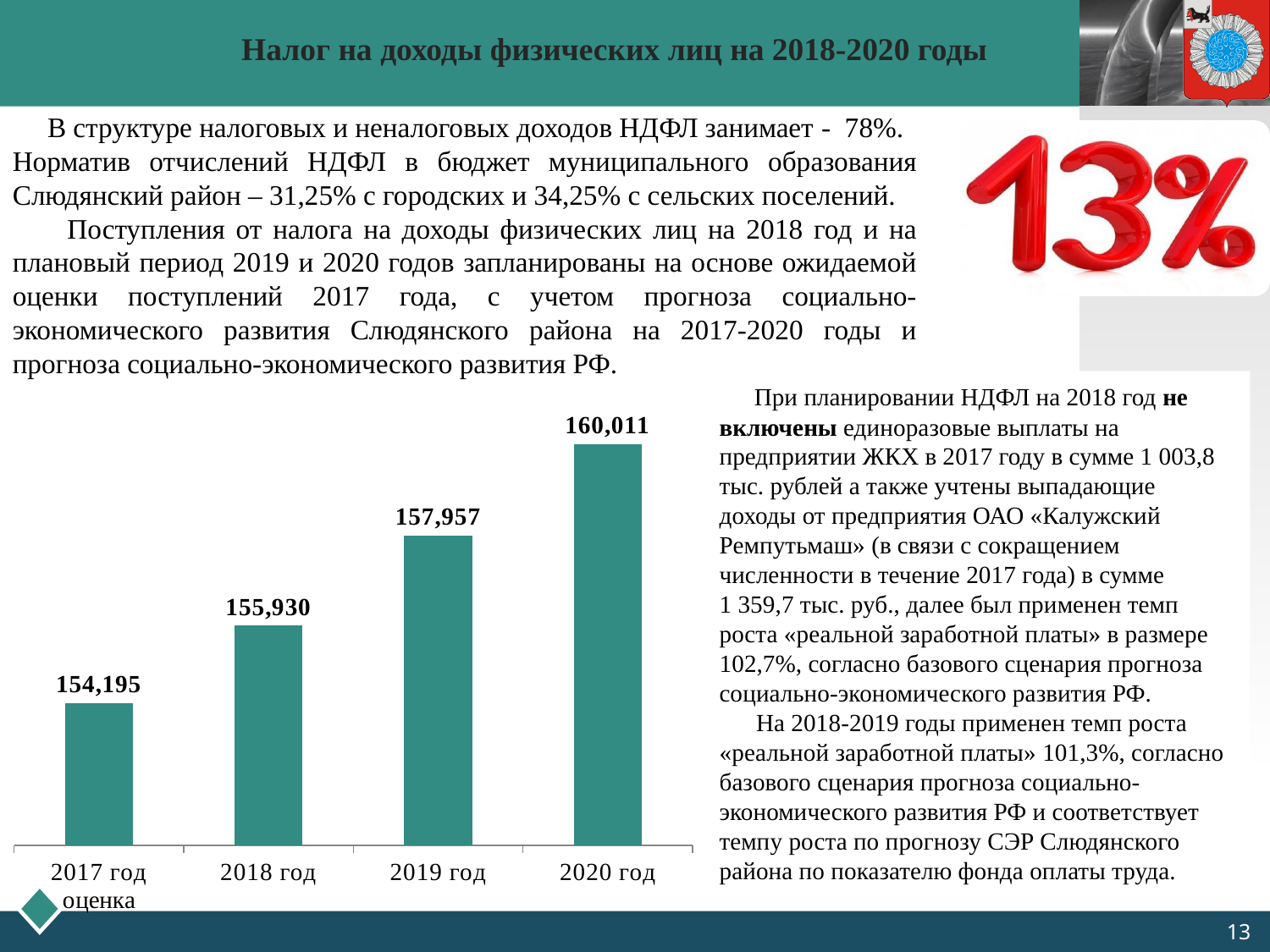
Which year has the highest value on the bar chart? 2020 год Which year has the lowest value on the bar chart? 2017 год Which is larger, the value for 2018 год or the value for 2019 год? 2019 год What is the value shown for 2019 год on the bar chart? 157,957 What is the value shown for 2017 год on the bar chart? 154,195 What is the value shown for 2020 год on the bar chart? 160,011 What is the value shown for 2018 год on the bar chart? 155,930 What is the difference between the values for 2020 год and 2017 год? 5,816 Do the values rise or fall from 2017 год to 2020 год? Rise How many bars are shown on the chart? 4 What type of chart is shown on the slide? Bar chart What is the difference between the values for 2019 год and 2018 год? 2,027